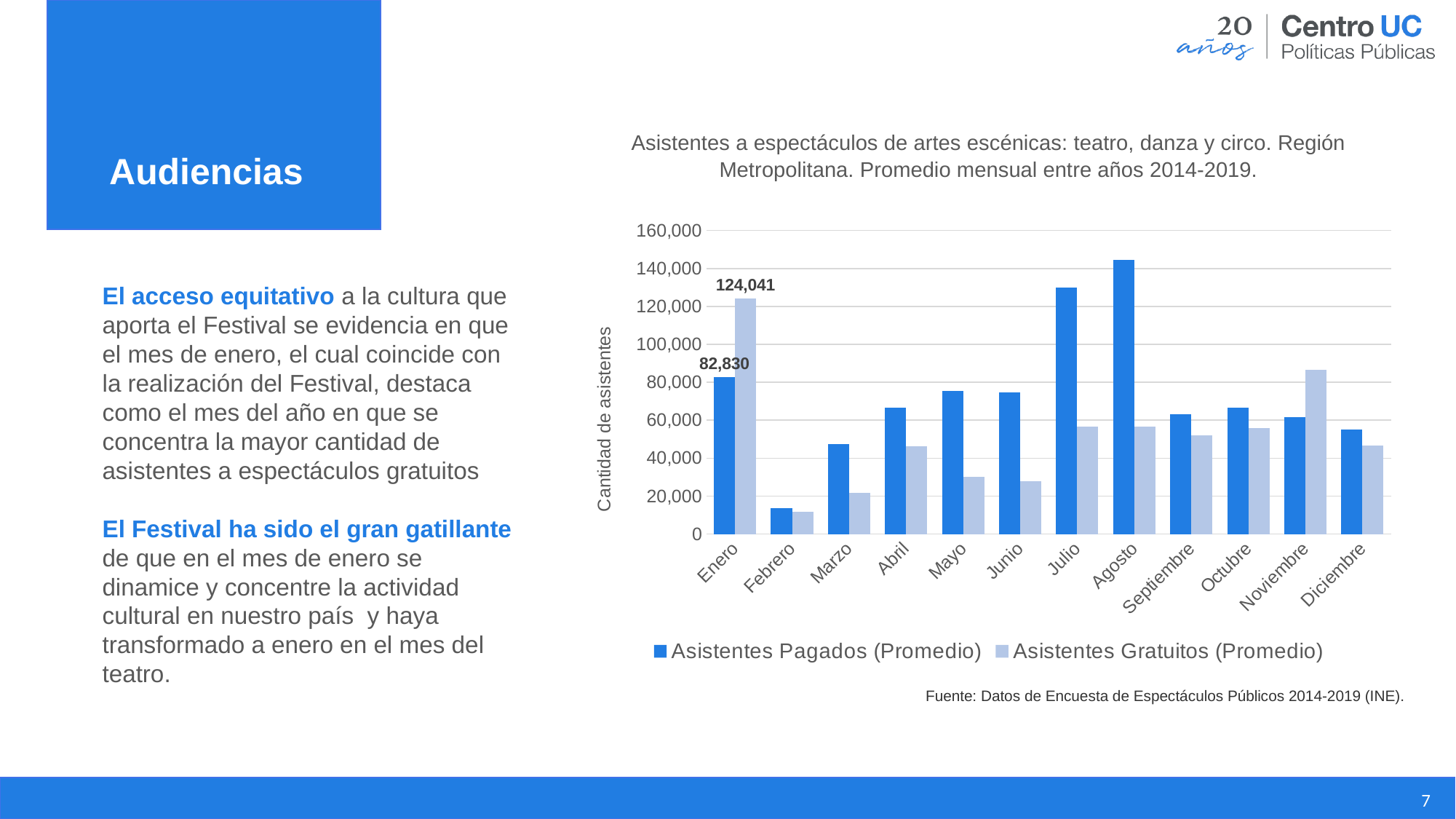
Which month has the highest value for Asistentes Pagados (Promedio)? Agosto Which month has the lowest value for Asistentes Pagados (Promedio)? Febrero Is the value for Asistentes Gratuitos (Promedio) in Noviembre greater or less than 80,000? greater What is the value for Asistentes Gratuitos (Promedio) in Enero? 124,041 In Enero, which is larger: Asistentes Pagados (Promedio) or Asistentes Gratuitos (Promedio)? Asistentes Gratuitos (Promedio) Which month has the highest value for Asistentes Gratuitos (Promedio)? Enero What is the value for Asistentes Pagados (Promedio) in Enero? 82,830 What is the difference between Asistentes Gratuitos and Asistentes Pagados in Enero? 41,211 What kind of chart is shown on the slide? Bar chart How many months are shown on the x axis of the chart? 12 Is the value for Asistentes Pagados (Promedio) in Julio greater or less than 120,000? greater How many series does the chart's legend list? 2